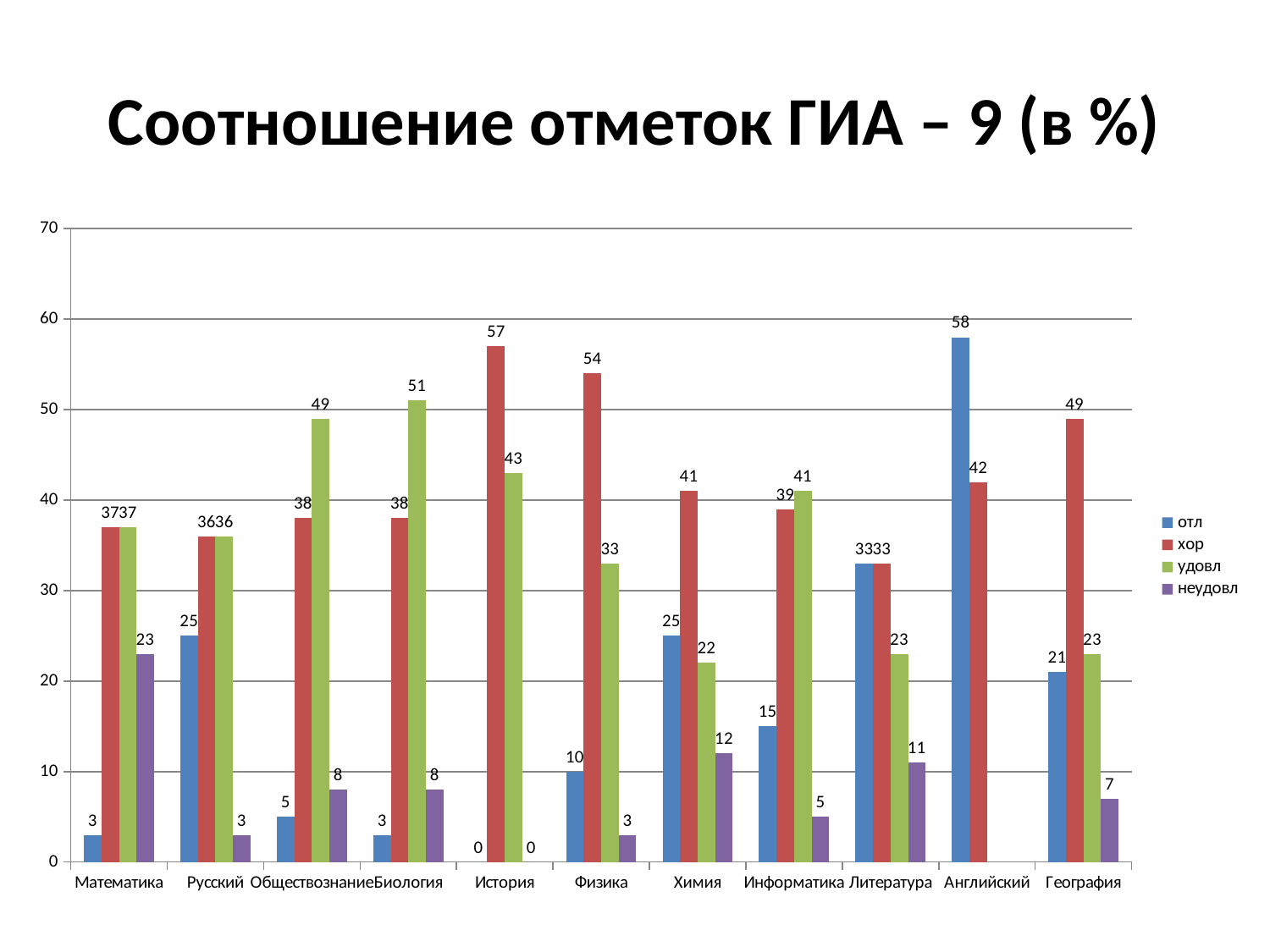
How many subjects are shown on the x axis? 11 Which subject has the highest value in the отл series? Английский What kind of chart is shown on the slide? bar chart What is the value of the удовл series for Информатика? 41 Which subject has the larger отл value, Химия or Информатика? Химия Is the хор value for Физика greater or less than 50? greater What is the difference between the удовл value for Биология and the удовл value for Обществознание? 2 What is the value of the неудовл series for Математика? 23 What is the title of the chart? Соотношение отметок ГИА – 9 (в %) How many series does the legend list? 4 What is the value of the хор series for История? 57 Which subject has the lowest value in the хор series? Литература